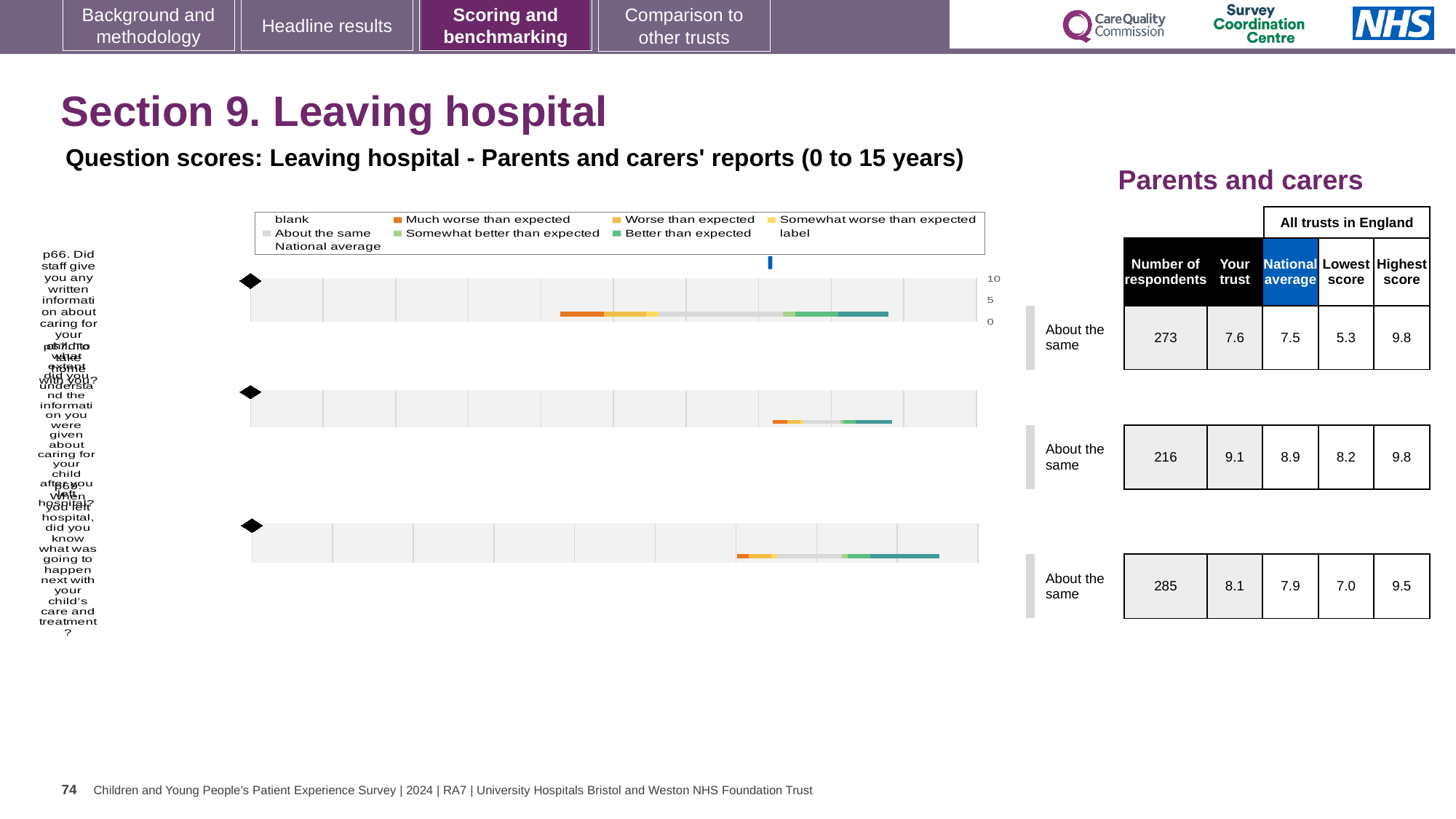
How many question rows (charts) are plotted on the slide? 3 What benchmark category is shown for all three question rows? About the same In the table beside the charts, what is the 'Your trust' score for the top row (p66)? 7.6 For the top row (p66), which is larger: the 'Your trust' score or the national average? Your trust In the table beside the charts, how many respondents are recorded for the bottom row (p68)? 285 In the legend, what colour represents 'About the same'? grey For the bottom row (p68), what is the difference between the highest score and the lowest score? 2.5 In the legend, what colour represents 'Much worse than expected'? orange What kind of chart is used to show the question scores on this slide? bar chart In the table beside the charts, what is the national average for the middle row (p67)? 8.9 How many entries does the legend above the charts list? 9 Which row has the highest 'Your trust' score in the table beside the charts? the middle row (p67), 9.1